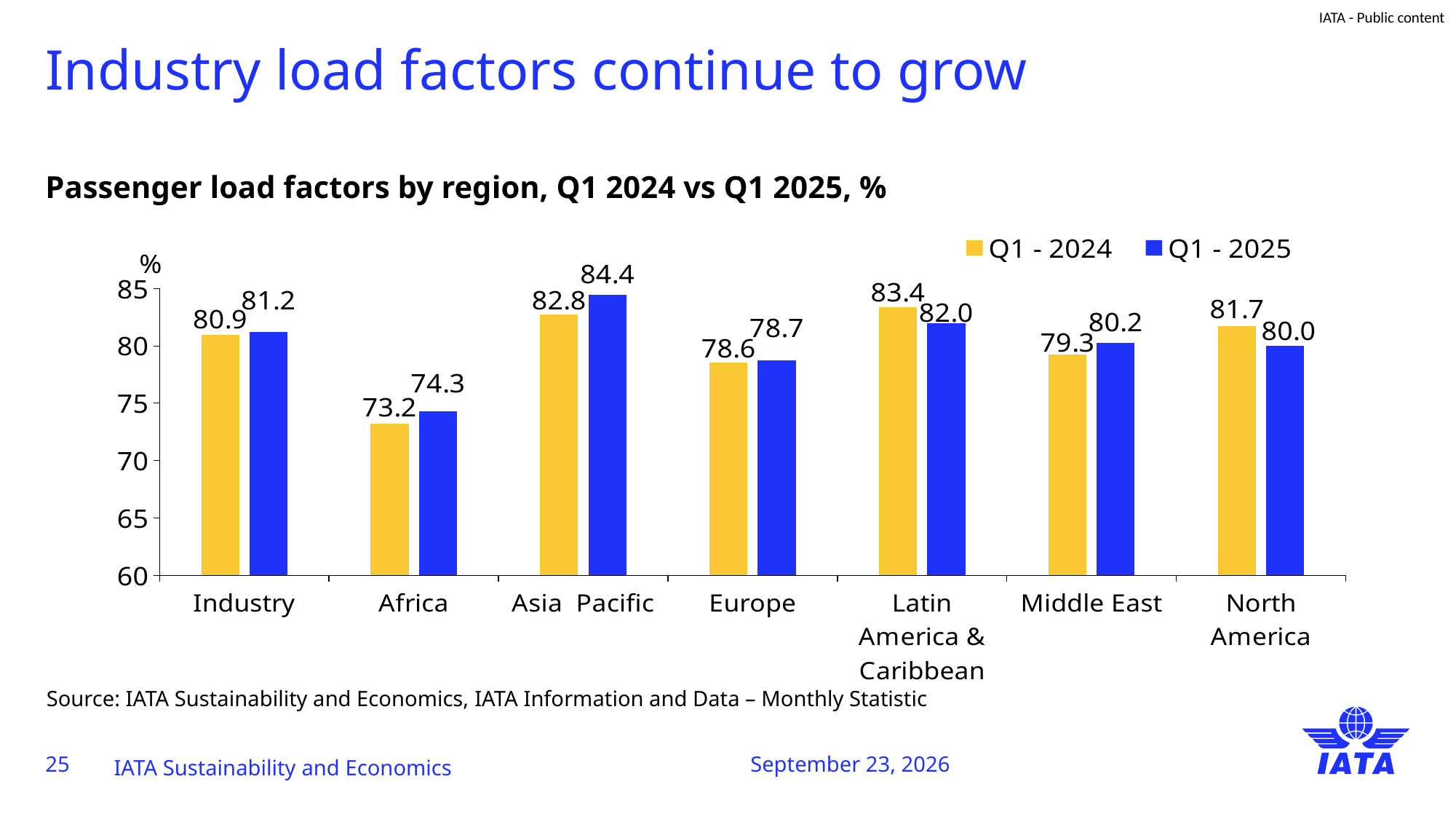
Which is larger for North America: the Q1 - 2024 value or the Q1 - 2025 value? Q1 - 2024 Is the Q1 - 2024 value for Europe greater or less than 80? less Which region has the lowest Q1 - 2024 load factor? Africa What is the Q1 - 2025 passenger load factor for Asia Pacific? 84.4 Which colour represents the Q1 - 2025 series? Blue How many series does the legend list? 2 What is the Q1 - 2024 passenger load factor for Africa? 73.2 What kind of chart is shown on the slide? Bar chart Which region has the highest Q1 - 2025 load factor? Asia Pacific How many regions (categories) are shown on the x axis? 7 What is the Q1 - 2025 value for Latin America & Caribbean? 82.0 What is the difference between the Q1 - 2025 and Q1 - 2024 load factors for Africa? 1.1